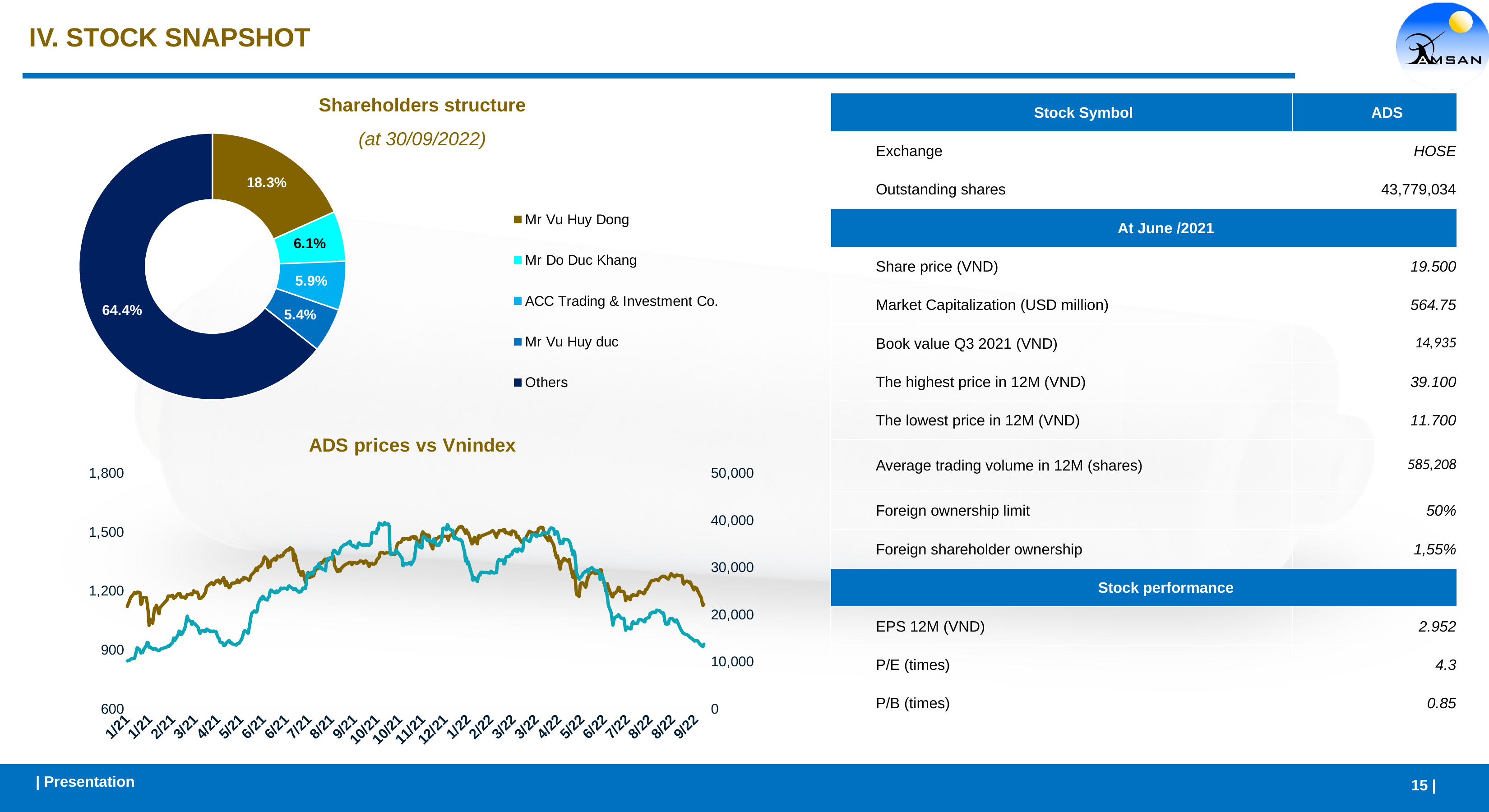
How many shareholder categories are shown in the Shareholders structure chart? 5 In the Shareholders structure chart, what share is held by Mr Do Duc Khang? 6.1% In the Shareholders structure chart, who holds a larger share, Mr Do Duc Khang or Mr Vu Huy duc? Mr Do Duc Khang What kind of chart is the Shareholders structure chart? Donut (pie) chart In the Shareholders structure chart, what share is held by Mr Vu Huy Dong? 18.3% In the Shareholders structure chart, what share is held by Others? 64.4% In the Shareholders structure chart, which shareholder has the smallest share? Mr Vu Huy duc What kind of chart is the ADS prices vs Vnindex chart? Line chart What date is the Shareholders structure chart stated to be as of? 30/09/2022 In the Shareholders structure chart, which shareholder category has the largest share? Others In the Shareholders structure chart, what is the difference between the shares of Mr Vu Huy Dong and Mr Do Duc Khang? 12.2% In the Shareholders structure chart, what share is held by ACC Trading & Investment Co.? 5.9%